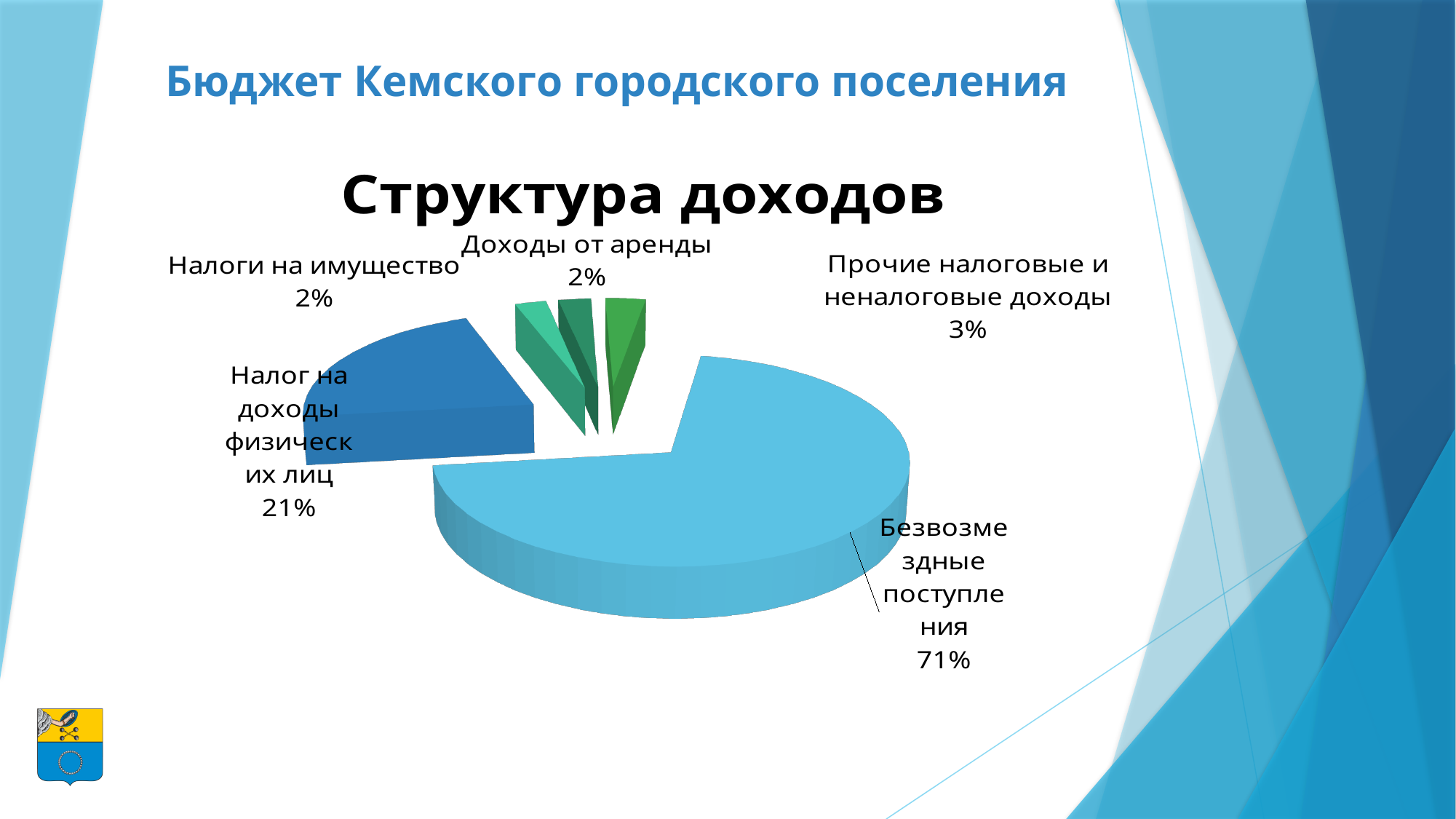
What share of the pie is labelled for Доходы от аренды? 2% Is the share for Безвозмездные поступления greater or less than 50%? greater What share of the pie is labelled for Прочие налоговые и неналоговые доходы? 3% What share of the pie is labelled for Безвозмездные поступления? 71% What type of chart is shown on the slide? Pie chart Which category has the largest share of the pie? Безвозмездные поступления What is the difference in percentage points between Безвозмездные поступления and Налог на доходы физических лиц? 50 What is the title of the chart? Структура доходов How many slices does the pie chart have? 5 Which is larger: the share for Налог на доходы физических лиц or the share for Прочие налоговые и неналоговые доходы? Налог на доходы физических лиц